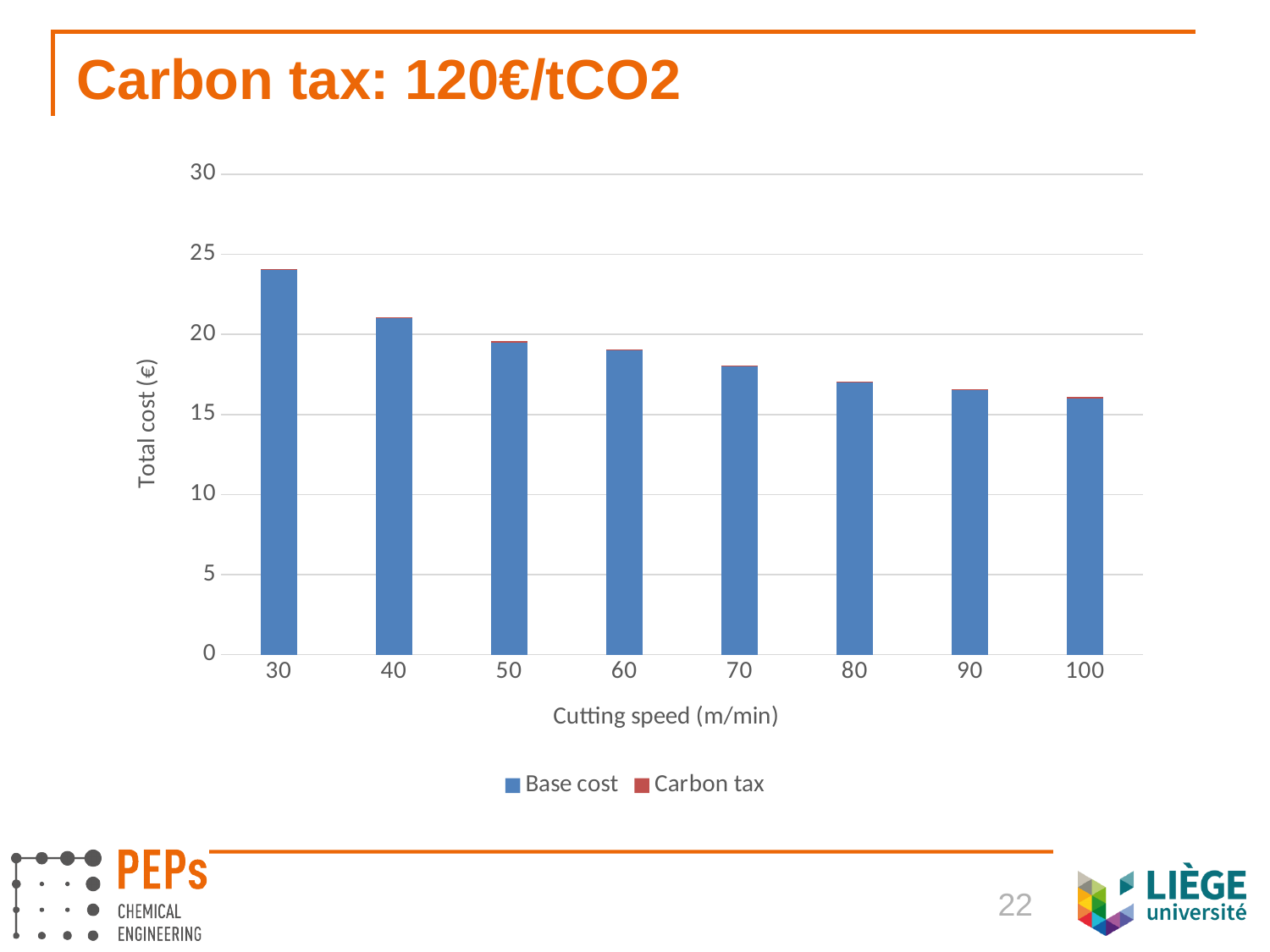
What are the two series named in the legend? Base cost and Carbon tax What is the title of the slide containing the chart? Carbon tax: 120€/tCO2 Which cutting speed has the lowest total cost? 100 How many series does the legend list? 2 Is the total cost for a cutting speed of 80 m/min greater or less than 15? greater Do the total cost values rise or fall as cutting speed increases along the x axis? fall How many cutting speed categories are shown on the x axis? 8 Is the total cost for a cutting speed of 100 m/min greater or less than 20? less What kind of chart is shown on the slide? bar chart Which cutting speed has the highest total cost? 30 Is the total cost for a cutting speed of 30 m/min greater or less than 20? greater Which has a larger total cost, a cutting speed of 40 m/min or 70 m/min? 40